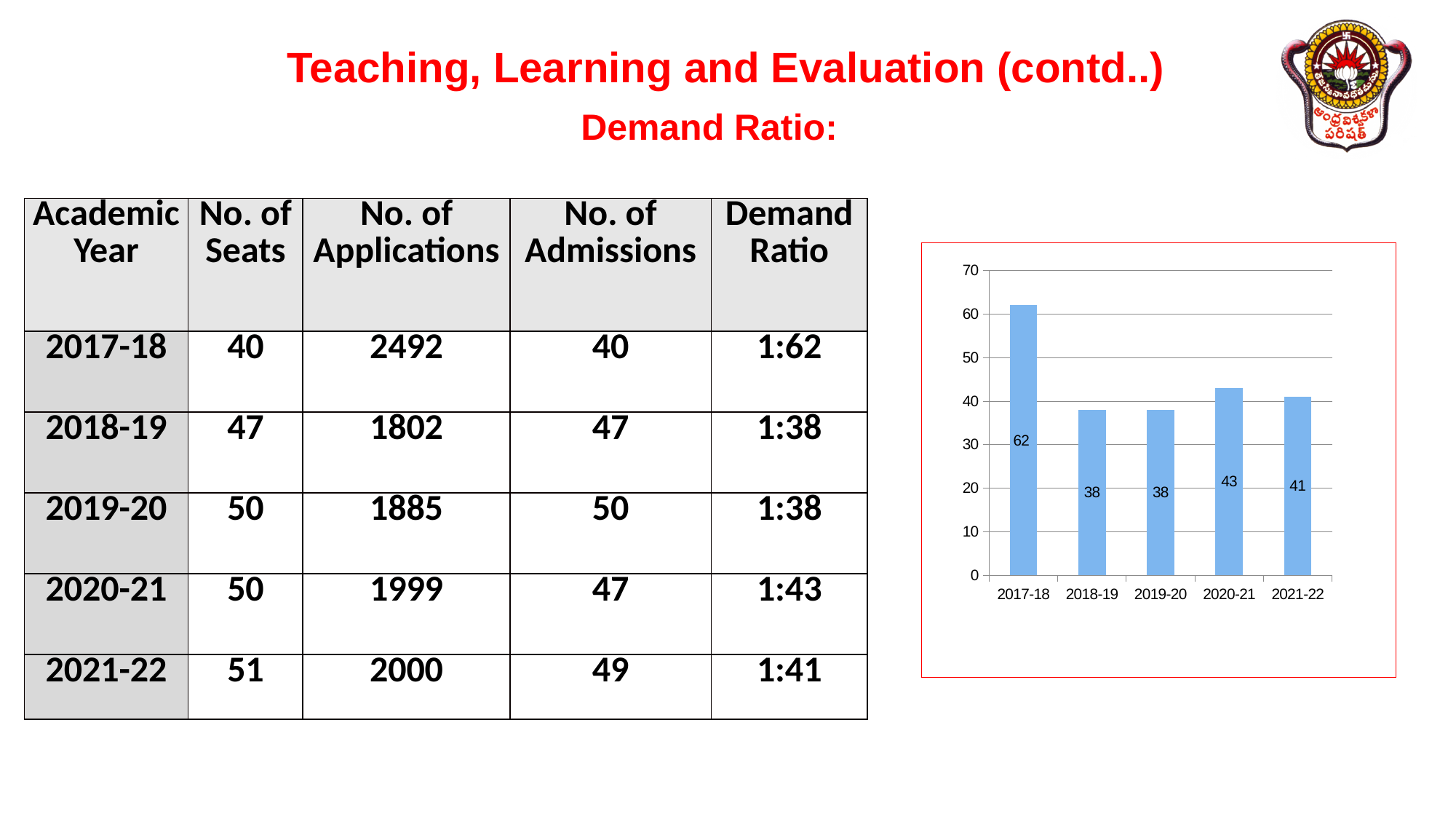
How many bars are plotted in the chart? 5 What kind of chart is shown on the slide? bar chart Is the value for 2017-18 greater or less than 50? greater Is the value for 2018-19 greater or less than 40? less What value does the bar for 2020-21 show? 43 What value does the bar for 2021-22 show? 41 What is the highest value shown on the chart's vertical axis? 70 What is the difference between the values for 2020-21 and 2021-22? 2 Which is larger, the value for 2020-21 or the value for 2019-20? 2020-21 Which year has the highest bar in the chart? 2017-18 What is the difference between the values for 2017-18 and 2018-19? 24 What value does the bar for 2017-18 show? 62